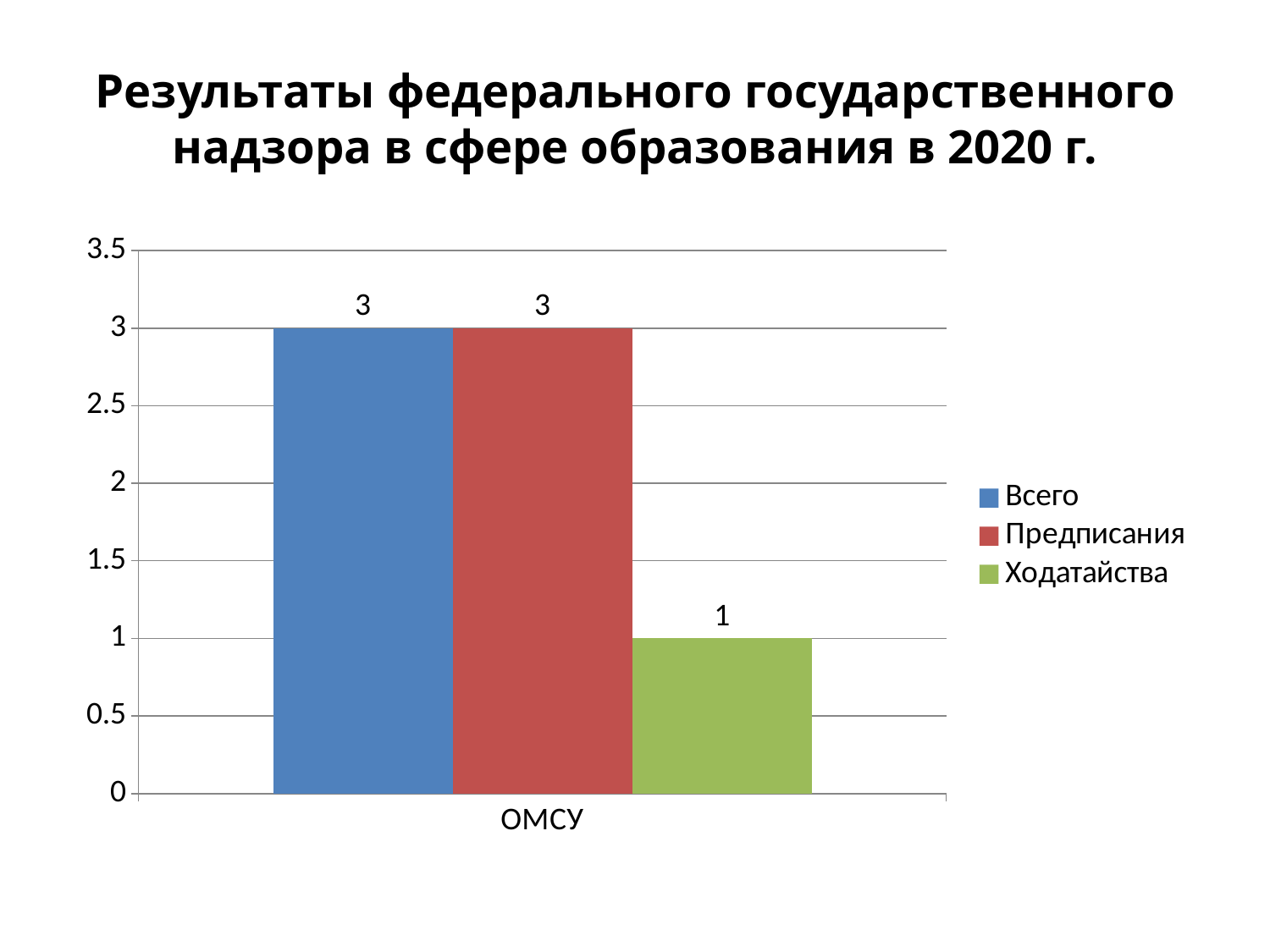
What is the value of the Всего series for ОМСУ? 3 Is the value for Ходатайства greater or less than 2? less What is the title of the slide? Результаты федерального государственного надзора в сфере образования в 2020 г. How many categories are shown on the x axis? 1 What is the difference between the Всего value and the Ходатайства value for ОМСУ? 2 Which series has the lowest value for ОМСУ? Ходатайства What is the value of the Ходатайства series for ОМСУ? 1 How many series does the legend list? 3 What colour represents the Предписания series? red What is the value of the Предписания series for ОМСУ? 3 What kind of chart is shown on the slide? bar chart Which is larger for ОМСУ: the Предписания value or the Ходатайства value? Предписания